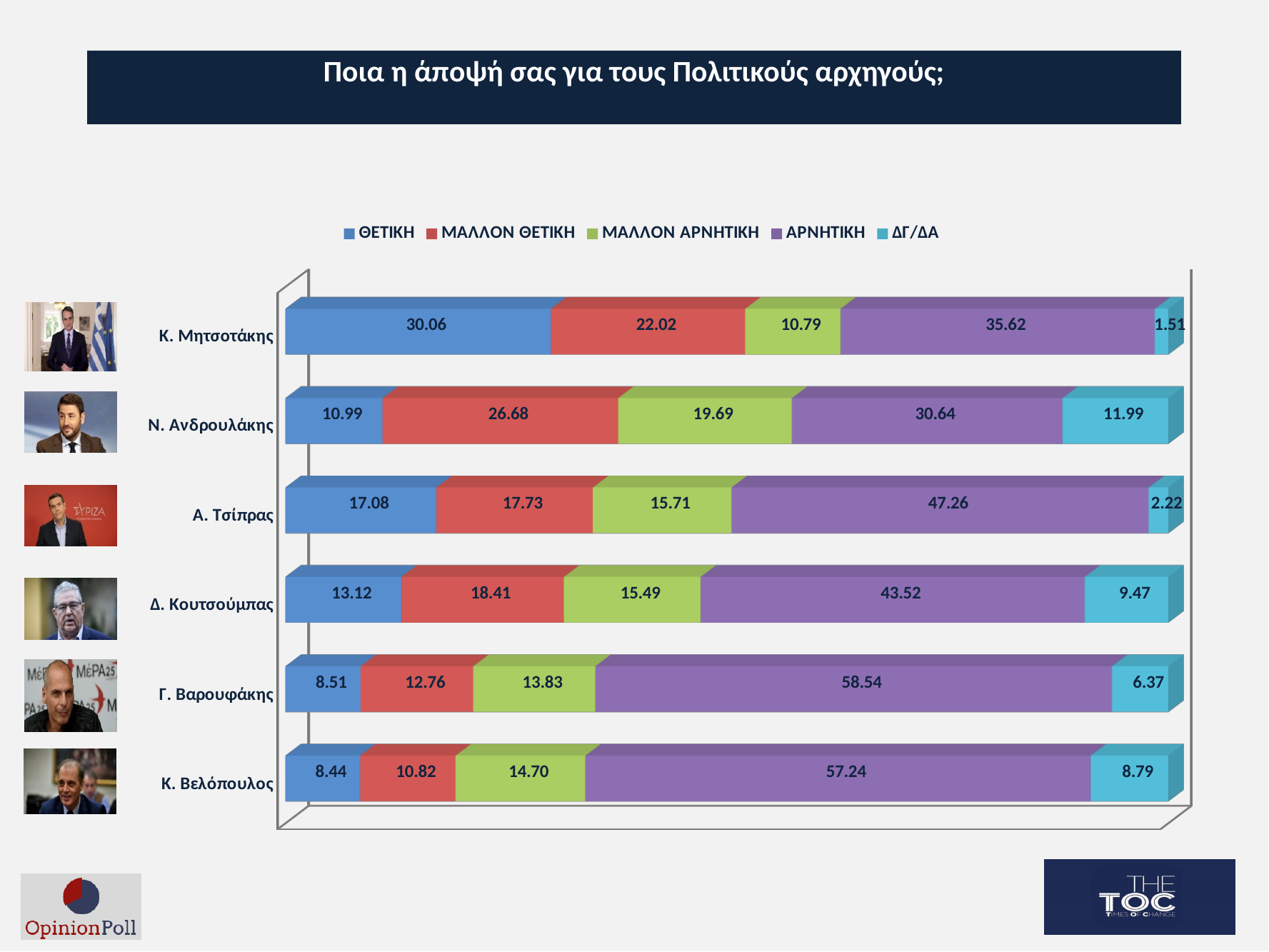
What is the ΑΡΝΗΤΙΚΗ value for Γ. Βαρουφάκης? 58.54 Which politician has the lowest ΘΕΤΙΚΗ value? Κ. Βελόπουλος What is the title of the chart? Ποια η άποψή σας για τους Πολιτικούς αρχηγούς; How many series does the legend list? 5 Which politician has the highest ΑΡΝΗΤΙΚΗ value? Γ. Βαρουφάκης Who has the larger ΜΑΛΛΟΝ ΘΕΤΙΚΗ value, Ν. Ανδρουλάκης or Κ. Μητσοτάκης? Ν. Ανδρουλάκης Which politician has the highest ΘΕΤΙΚΗ value? Κ. Μητσοτάκης What is the ΔΓ/ΔΑ value for Ν. Ανδρουλάκης? 11.99 What kind of chart is shown on the slide? Stacked bar chart How many politicians are shown in the chart? 6 What is the ΘΕΤΙΚΗ value for Κ. Μητσοτάκης? 30.06 What is the difference between the ΑΡΝΗΤΙΚΗ values for Α. Τσίπρας and Κ. Μητσοτάκης? 11.64